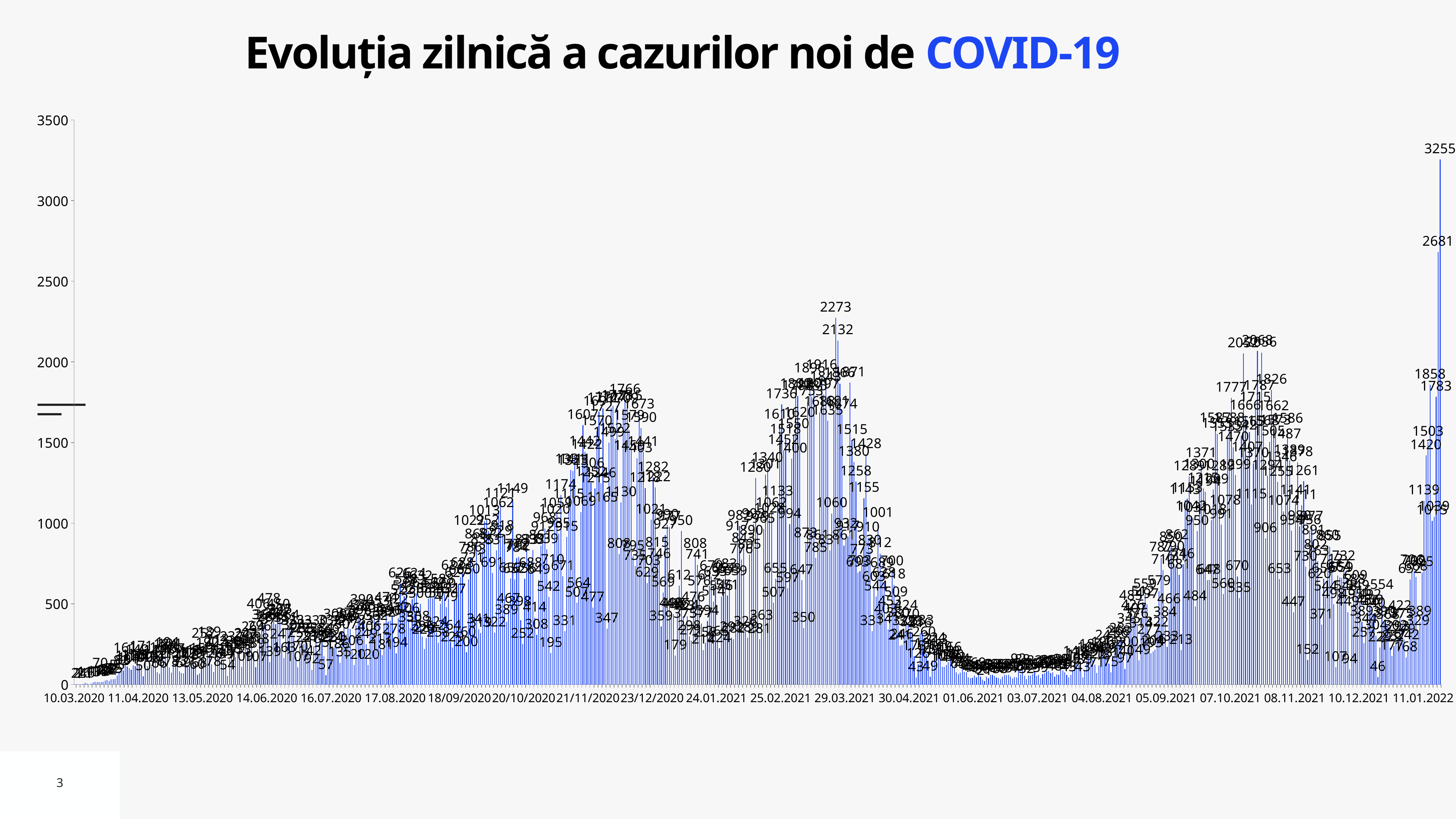
What is the first date shown on the x axis? 10.03.2020 Is the peak of the March 2021 wave (2273) greater or less than 2500? less What is the highest tick value on the y axis? 3500 Which is larger, the 2273 peak of the March 2021 wave or the 2132 value next to it? 2273 What is the second-highest value labeled on the chart, just before the 3255 peak? 2681 What is the difference between the two highest labeled values, 3255 and 2681? 574 What is the highest value labeled on the chart? 3255 What kind of chart is shown on the slide? bar chart What is the difference between the labeled values 2273 and 2132 in the March 2021 wave? 141 What is the title of the chart? Evoluția zilnică a cazurilor noi de COVID-19 Is the highest value on the chart greater or less than 3000? greater What is the highest value labeled in the wave around 29.03.2021? 2273